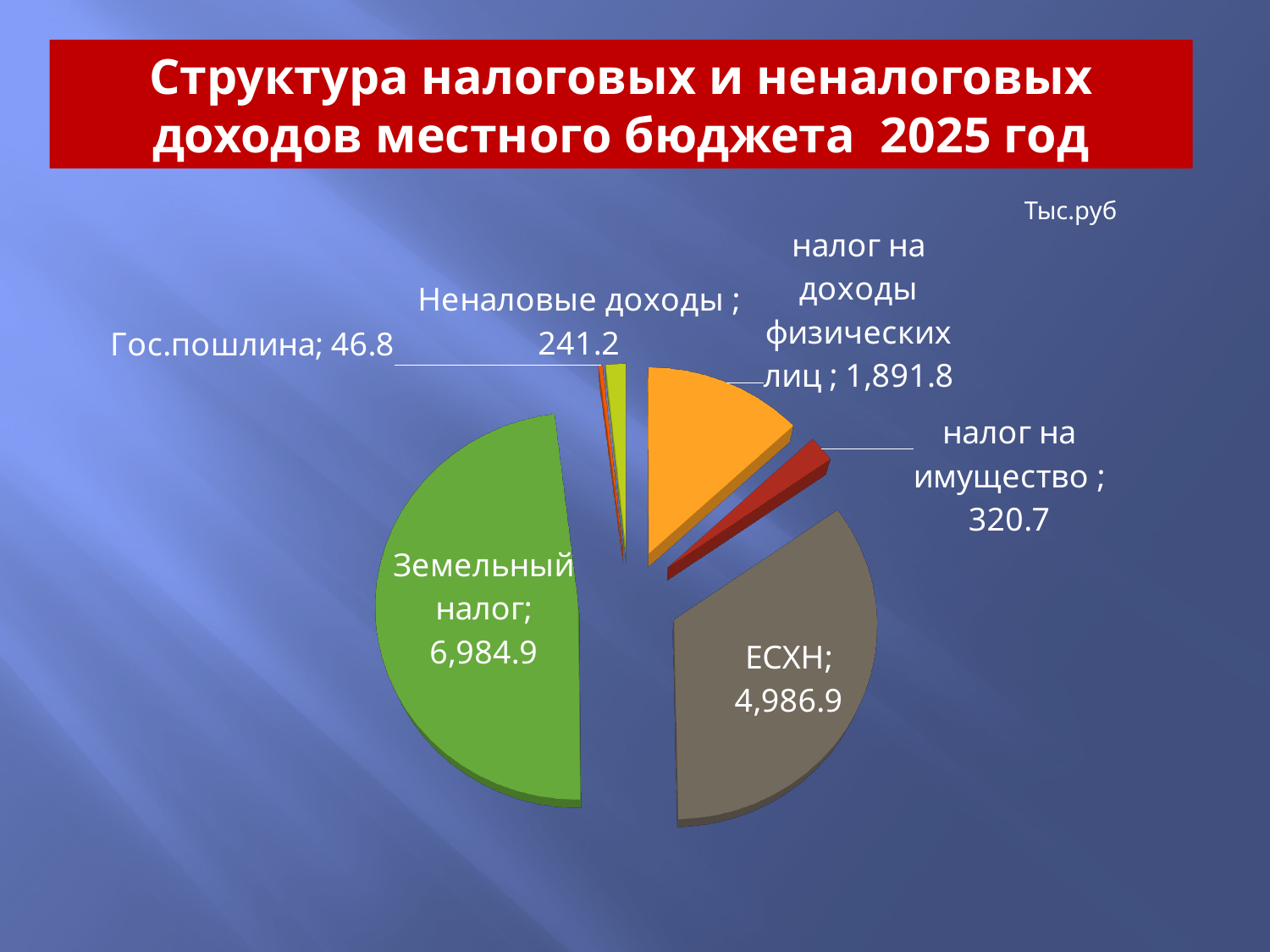
In what units are the values on the chart given? Тыс.руб Which category has the smallest slice of the pie? Гос.пошлина What is the value for Земельный налог? 6,984.9 How many slices does the pie chart have? 6 Which category has the largest slice of the pie? Земельный налог Which is larger, налог на имущество or Неналовые доходы? налог на имущество What is the value for налог на доходы физических лиц? 1,891.8 What is the value for Неналовые доходы? 241.2 What is the value for Гос.пошлина? 46.8 What is the difference between Земельный налог and ЕСХН? 1,998.0 What is the value for ЕСХН? 4,986.9 What type of chart is shown on the slide? pie chart